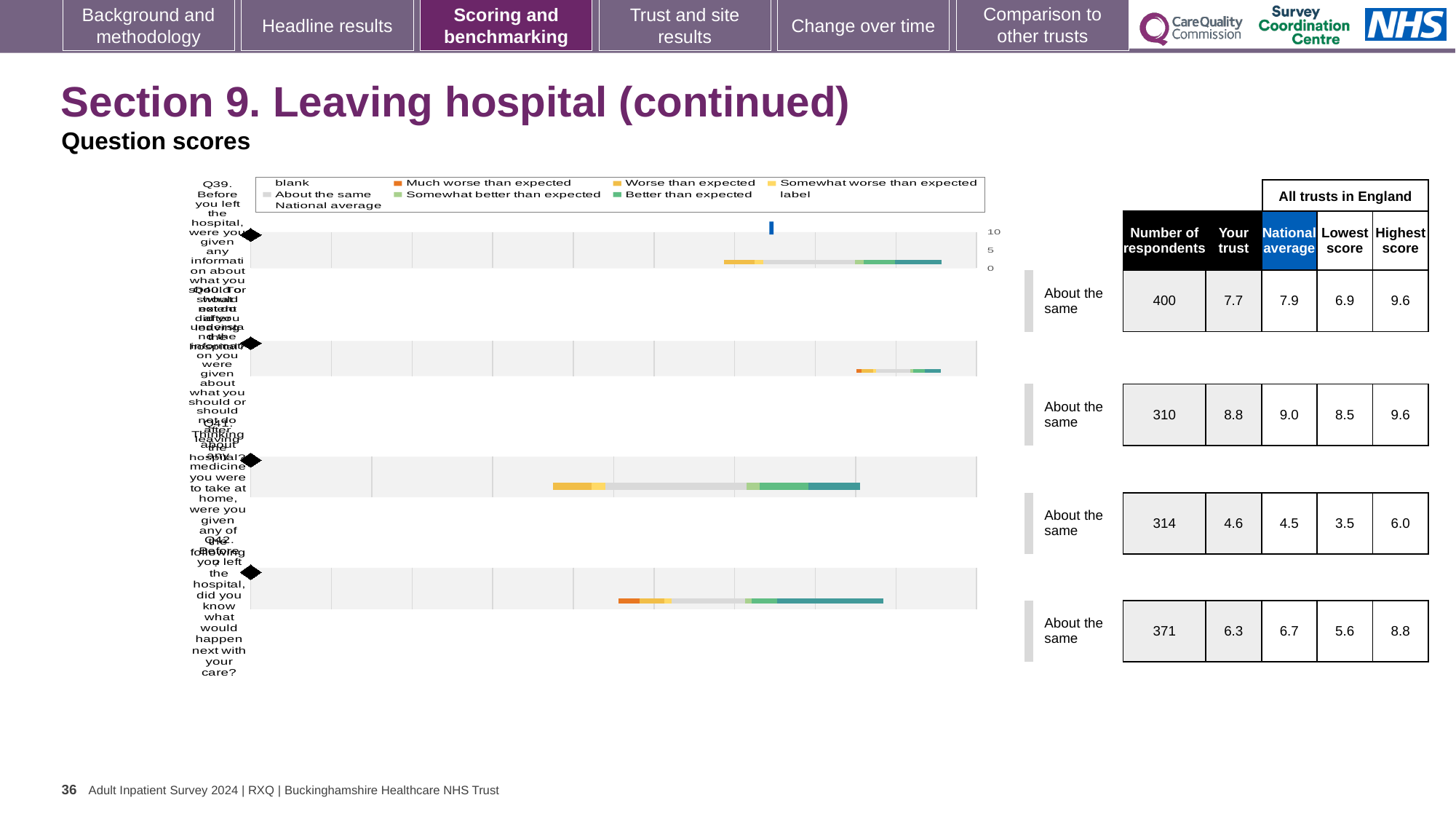
Which row in the table has the lowest 'Your trust' score? the third row (4.6) For Q39 (the first row), is the 'Your trust' score or the national average larger? national average In the table, what is the 'Your trust' score for Q39 (the first row)? 7.7 Which row in the table has the highest 'Your trust' score? the second row (8.8) In the table, what is the number of respondents for Q39 (the first row)? 400 How many question rows are plotted in the chart? 4 In the table, what is the national average for Q42 (the last row)? 6.7 What is the highest value shown on the chart's axis? 10 In the table, what is the 'Your trust' score for Q42 (the last row)? 6.3 What kind of chart is shown on the slide? bar chart In the chart legend, which category is shown in orange? Much worse than expected What is the difference between the national average and the 'Your trust' score for Q42 (the last row)? 0.4